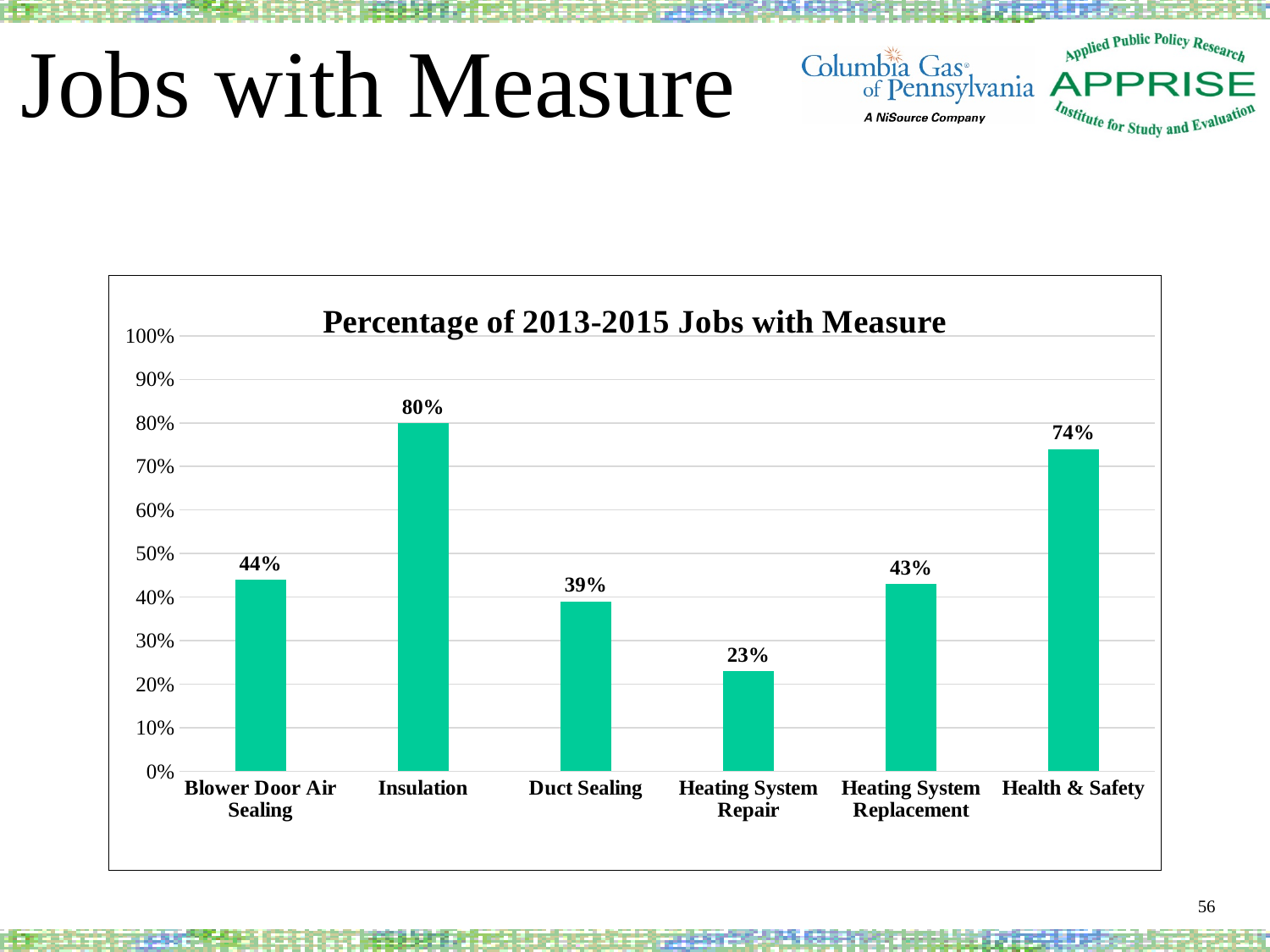
What is the difference in percentage points between Insulation and Duct Sealing? 41 How many measure categories are shown on the chart? 6 Which is larger, the value for Blower Door Air Sealing or the value for Heating System Replacement? Blower Door Air Sealing What percentage of jobs included Heating System Repair? 23% Which measure has the lowest percentage of jobs? Heating System Repair What type of chart is shown on the slide? Bar chart What is the difference in percentage points between Health & Safety and Heating System Repair? 51 What is the title of the chart? Percentage of 2013-2015 Jobs with Measure Is the value for Health & Safety greater or less than 70%? greater Which measure has the highest percentage of jobs? Insulation What percentage of 2013-2015 jobs included Insulation? 80% What is the value shown for Health & Safety? 74%